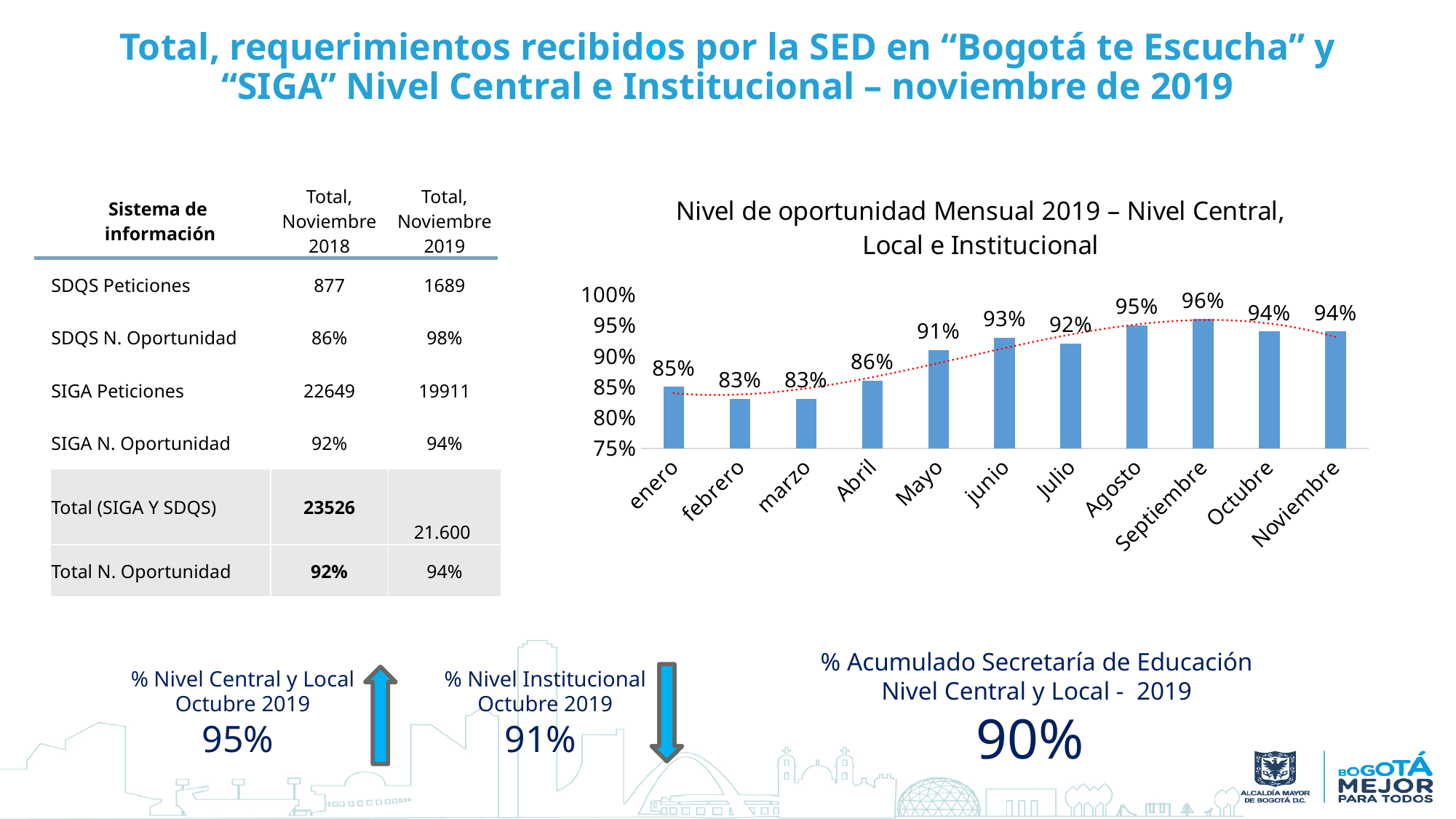
What is the value for Septiembre in the chart? 96% What is the value for enero in the chart? 85% What is the difference between the values for Septiembre and febrero? 13% What is the title of the chart? Nivel de oportunidad Mensual 2019 – Nivel Central, Local e Institucional Which is larger, the value for junio or the value for Julio? junio Do the values generally rise or fall from enero to Septiembre? rise Which month has the highest value in the chart? Septiembre What is the lowest value shown on the vertical axis of the chart? 75% How many months are plotted in the chart? 11 What kind of chart is shown on the slide? bar chart What is the value for Mayo in the chart? 91% Is the value for Abril greater or less than 90%? less